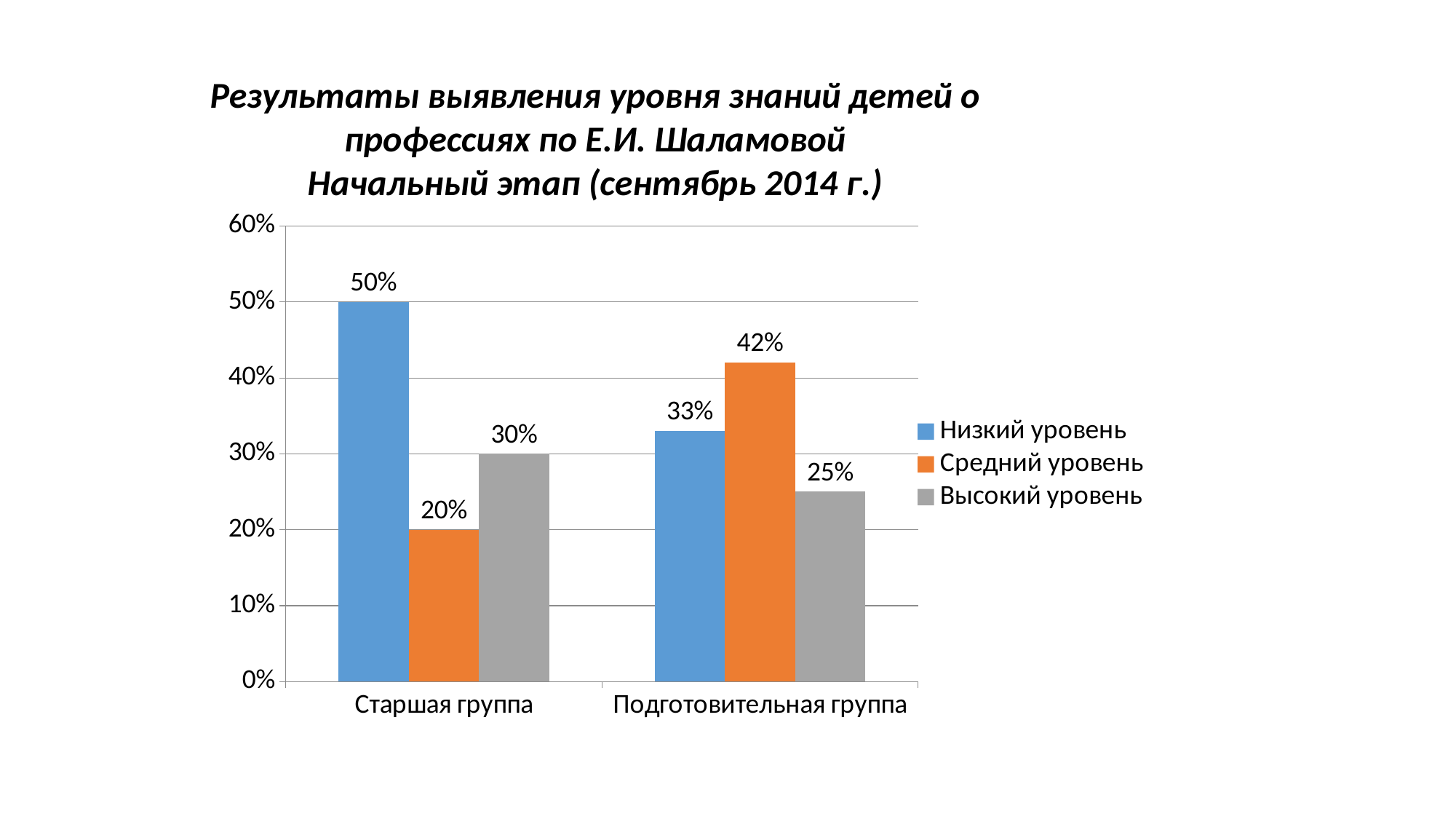
What is the value for Высокий уровень in Старшая группа? 30% What is the value for Низкий уровень in Старшая группа? 50% Which is larger: Высокий уровень in Старшая группа or Высокий уровень in Подготовительная группа? Старшая группа What kind of chart is shown on the slide? Bar chart Which level has the lowest value in Подготовительная группа? Высокий уровень What is the value for Средний уровень in Подготовительная группа? 42% What is the difference between Низкий уровень and Средний уровень in Старшая группа? 30% Which level has the highest value in Старшая группа? Низкий уровень How many series does the legend list? 3 What is the value for Низкий уровень in Подготовительная группа? 33% How many groups are shown on the x axis? 2 Which colour represents Средний уровень in the legend? Orange